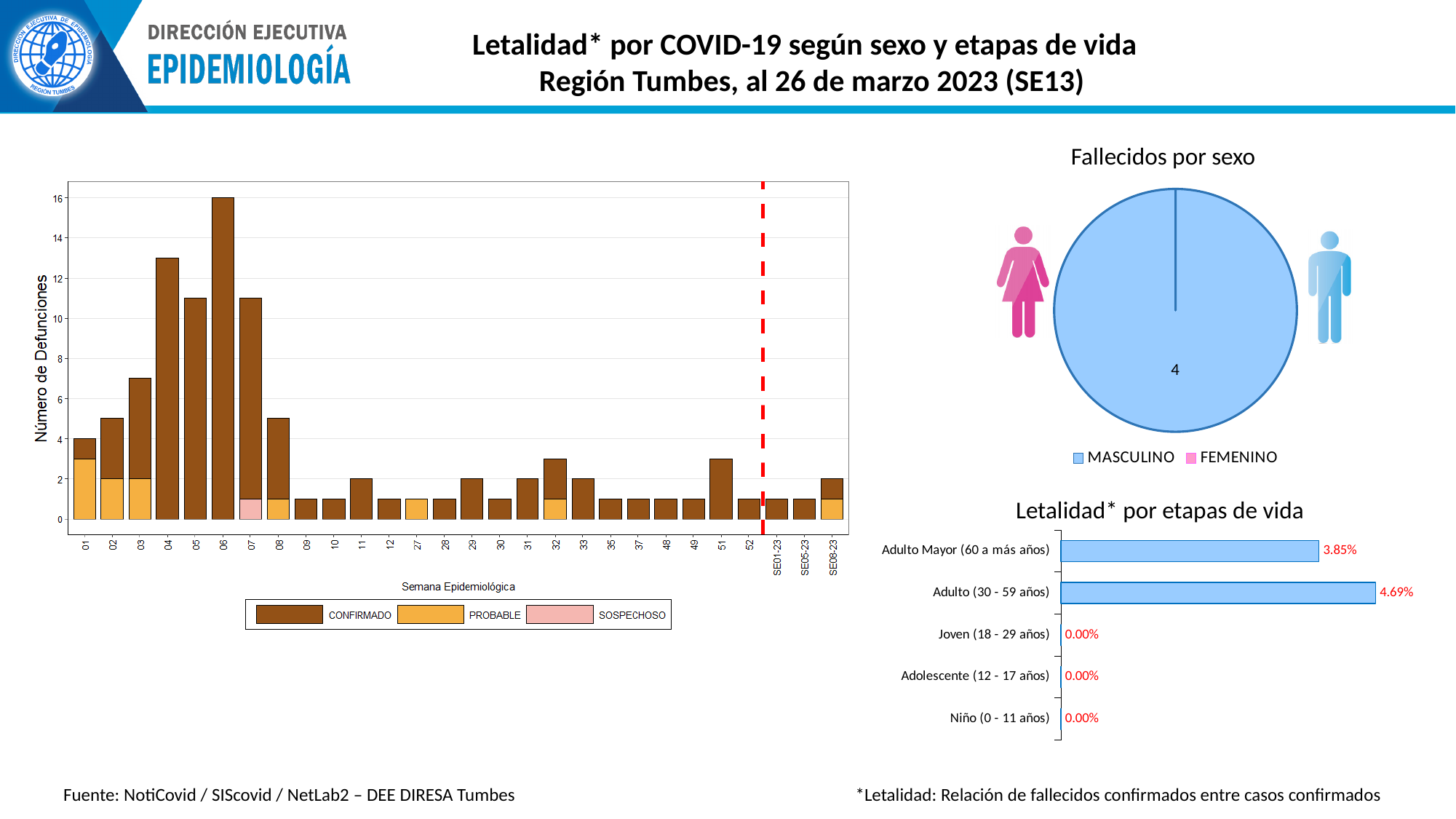
In the 'Letalidad* por etapas de vida' chart, what is the difference between the values for Adulto (30 - 59 años) and Adulto Mayor (60 a más años)? 0.84% In the 'Fallecidos por sexo' pie chart, which sex has the larger share? MASCULINO In the 'Letalidad* por etapas de vida' chart, what is the value for Adulto Mayor (60 a más años)? 3.85% In the 'Fallecidos por sexo' pie chart, what value is printed on the MASCULINO slice? 4 In the 'Letalidad* por etapas de vida' chart, which age group has the highest value? Adulto (30 - 59 años) In the chart on the left showing 'Número de Defunciones' by 'Semana Epidemiológica', which week has the highest total number of deaths? 06 In the 'Fallecidos por sexo' pie chart, how many entries does the legend list? 2 In the 'Letalidad* por etapas de vida' chart, what is the value for Adulto (30 - 59 años)? 4.69% In the 'Letalidad* por etapas de vida' chart, what is the value for Joven (18 - 29 años)? 0.00% In the 'Letalidad* por etapas de vida' chart, how many age groups are shown? 5 In the chart on the left showing 'Número de Defunciones' by 'Semana Epidemiológica', how many series does the legend list? 3 What kind of chart is the one on the left showing 'Número de Defunciones' by 'Semana Epidemiológica'? Stacked bar chart